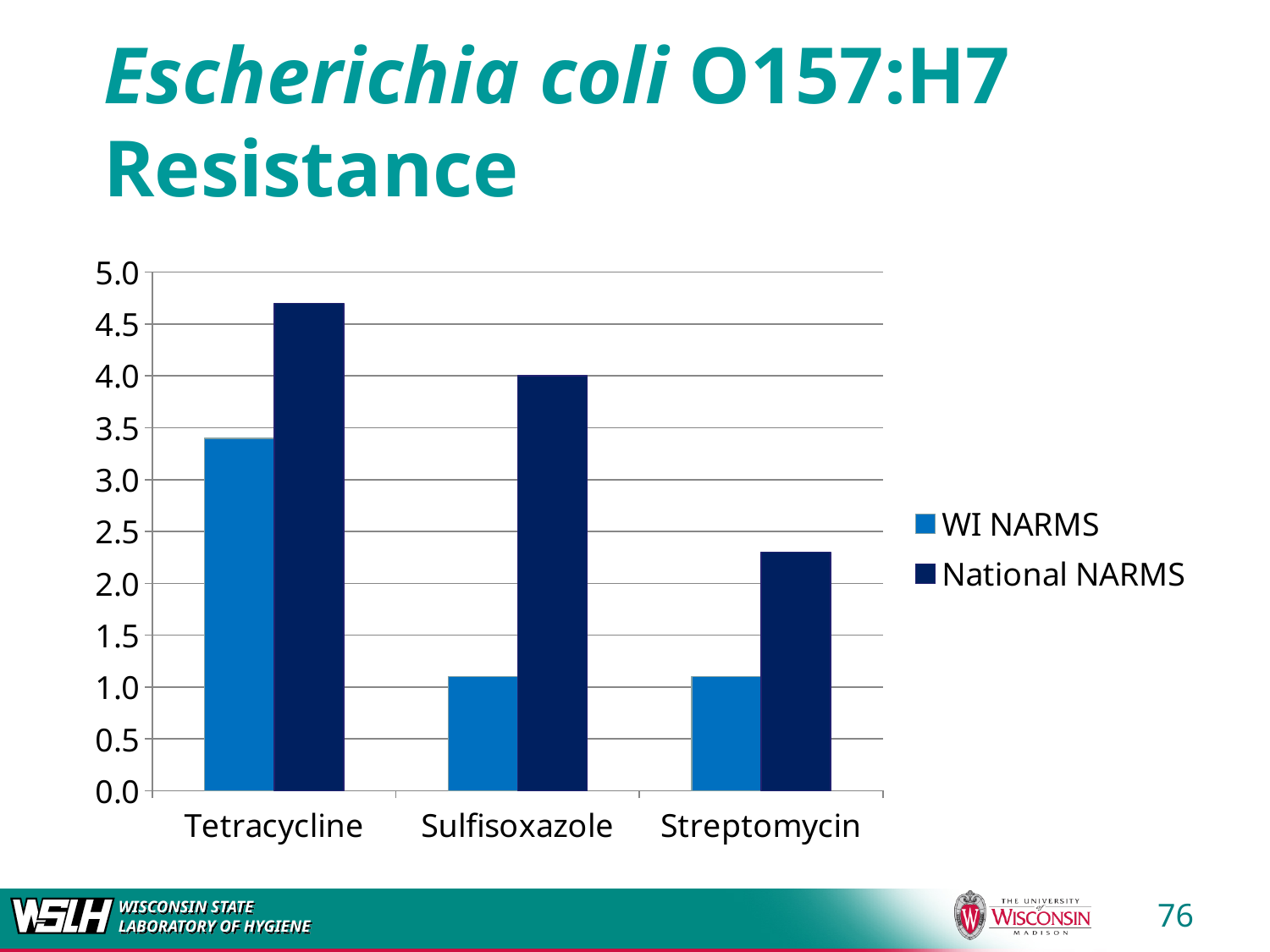
Is the WI NARMS value for Tetracycline greater or less than 3.0? greater Do the National NARMS values rise or fall from Tetracycline to Streptomycin along the x axis? fall Which antibiotic has the lowest National NARMS value? Streptomycin Which antibiotic has the highest National NARMS value? Tetracycline Which antibiotic has the highest WI NARMS value? Tetracycline How many series does the legend list? 2 For Sulfisoxazole, which series has the larger value, WI NARMS or National NARMS? National NARMS Is the National NARMS value for Streptomycin greater or less than 2.5? less What kind of chart is shown on the slide? bar chart Which series is shown in the darker navy bars? National NARMS How many antibiotic categories are shown on the x axis? 3 What is the National NARMS value for Sulfisoxazole? 4.0